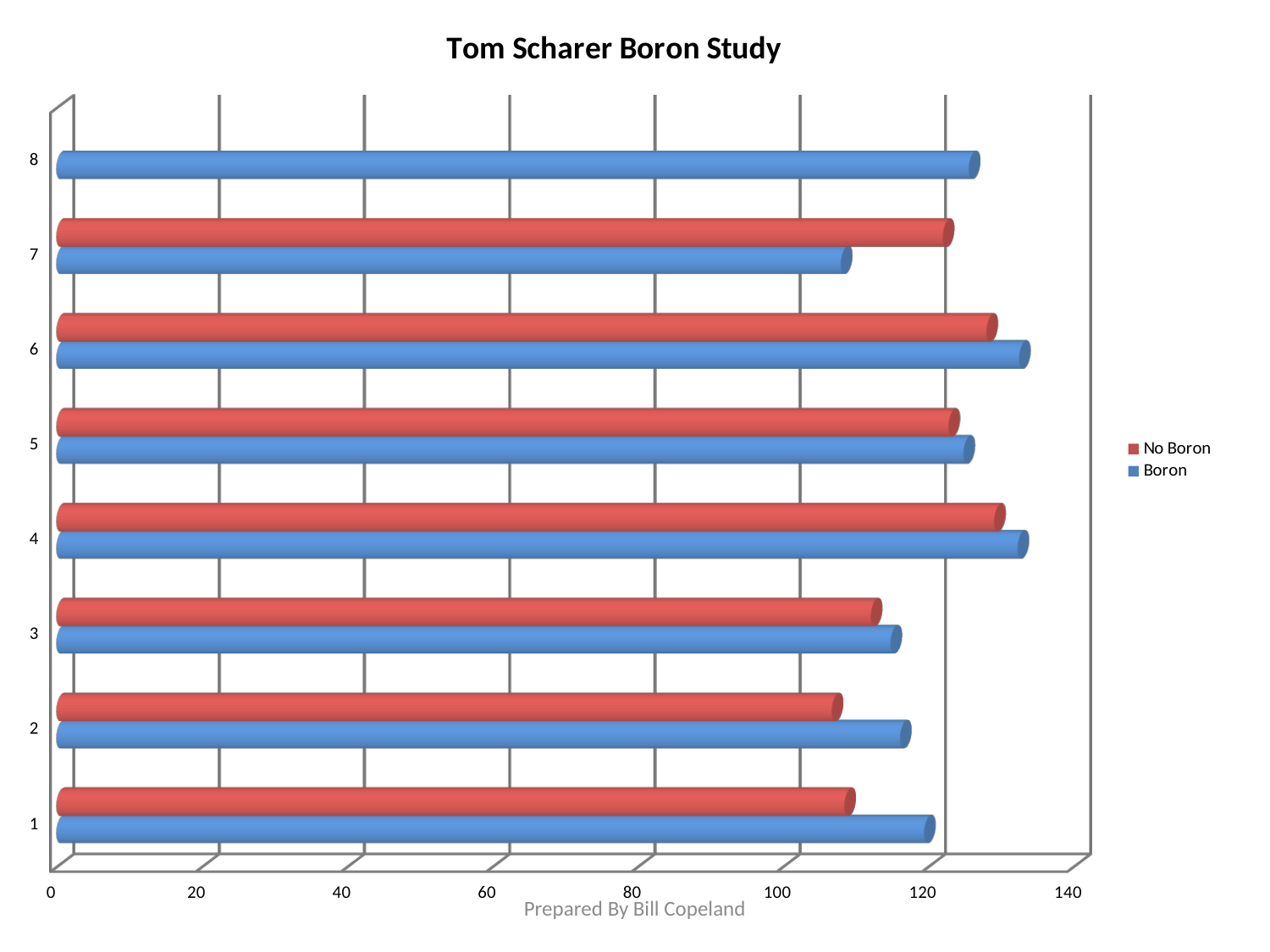
Which category has the lowest Boron value? 7 Is the Boron value for category 7 greater or less than 100? greater What kind of chart is shown on the slide? bar chart What is the title of the chart? Tom Scharer Boron Study Is the No Boron value for category 2 greater or less than 120? less Which series is drawn in blue? Boron Is the No Boron value for category 4 greater or less than 120? greater For category 1, which is larger: No Boron or Boron? Boron For category 7, which is larger: No Boron or Boron? No Boron How many categories are shown on the vertical axis? 8 How many series does the legend list? 2 For category 2, which is larger: No Boron or Boron? Boron